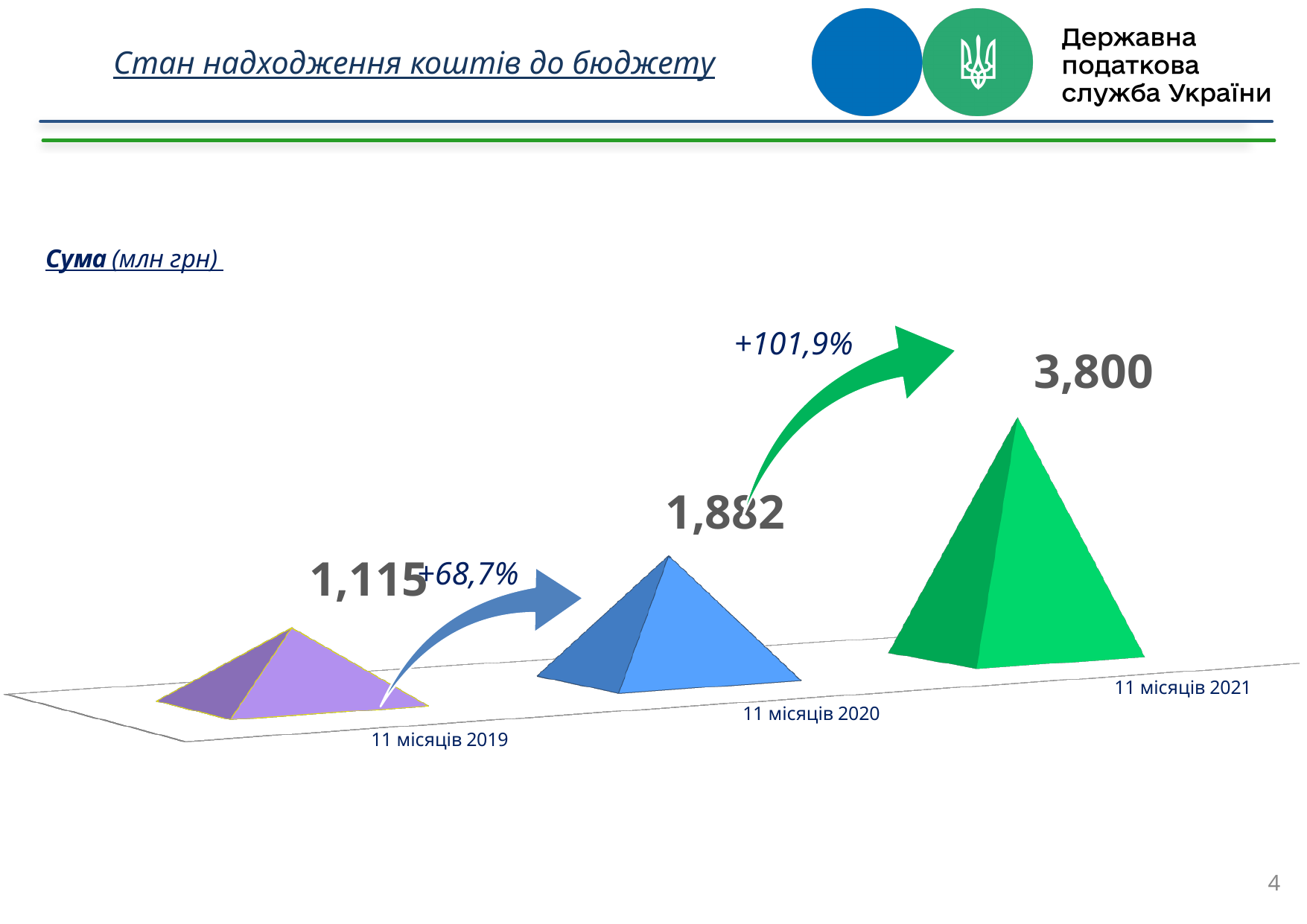
What percentage growth is shown between 11 місяців 2019 and 11 місяців 2020? +68,7% What percentage growth is shown between 11 місяців 2020 and 11 місяців 2021? +101,9% What kind of chart is shown on the slide? bar chart Which period has the lowest value? 11 місяців 2019 Which period has the highest value? 11 місяців 2021 What is the value for 11 місяців 2019? 1,115 What is the value for 11 місяців 2021? 3,800 Do the values rise or fall from 11 місяців 2019 to 11 місяців 2021? rise How many periods are shown in the chart? 3 What is the value for 11 місяців 2020? 1,882 Which is larger, the value for 11 місяців 2020 or for 11 місяців 2021? 11 місяців 2021 In what units are the values on the chart expressed? млн грн